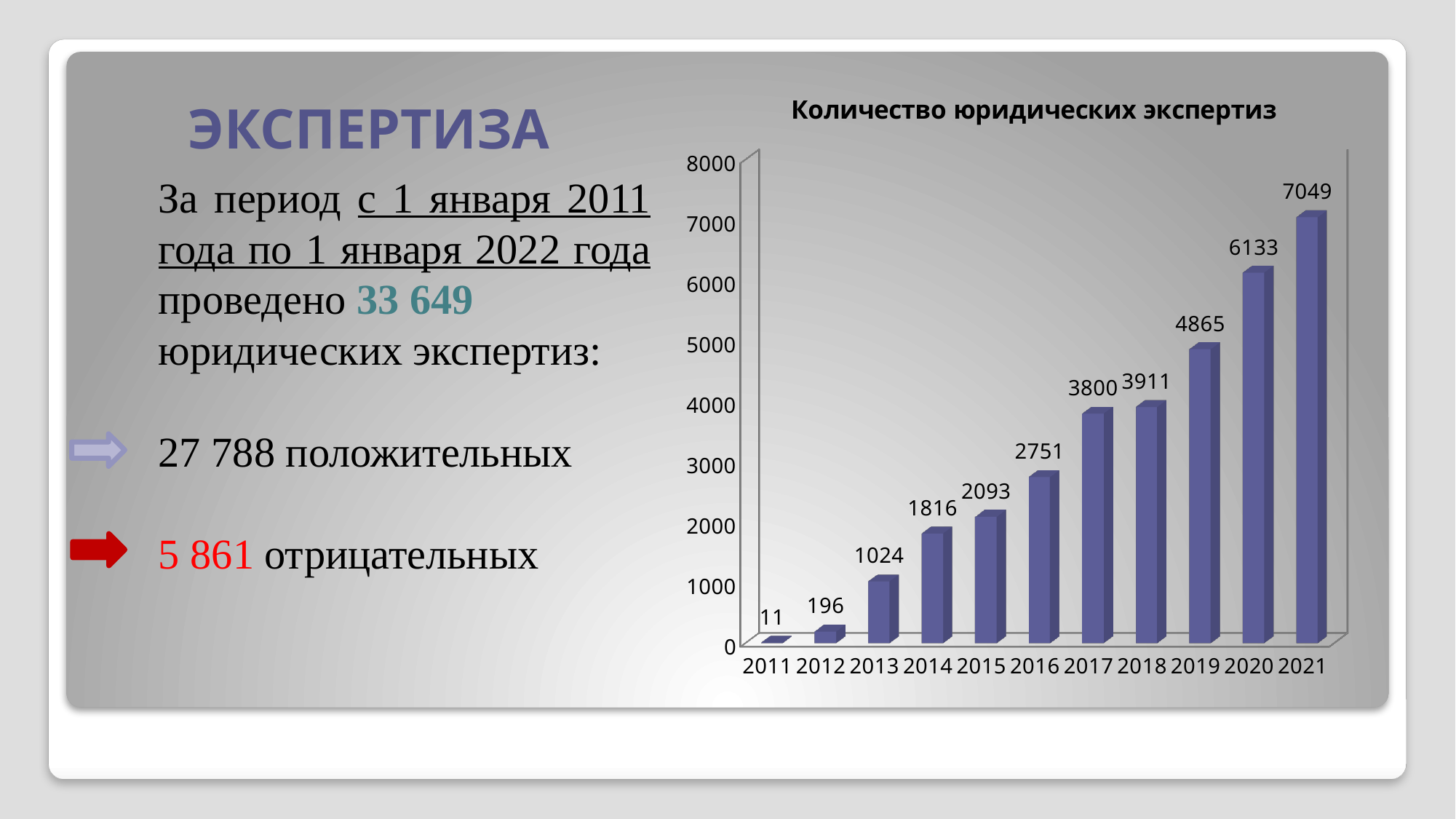
How many years are shown on the x axis of the chart? 11 What is the value for 2019 in the chart? 4865 What kind of chart is shown on the slide? bar chart What is the value for 2011 in the chart? 11 Which is larger, the value for 2016 or the value for 2015? 2016 Which year has the lowest value in the chart? 2011 What is the difference between the values for 2021 and 2020? 916 Is the value for 2020 greater or less than 6000? greater What is the value for 2013 in the chart? 1024 Which year has the highest value in the chart? 2021 What is the difference between the values for 2018 and 2017? 111 Do the values rise or fall from 2011 to 2021? rise